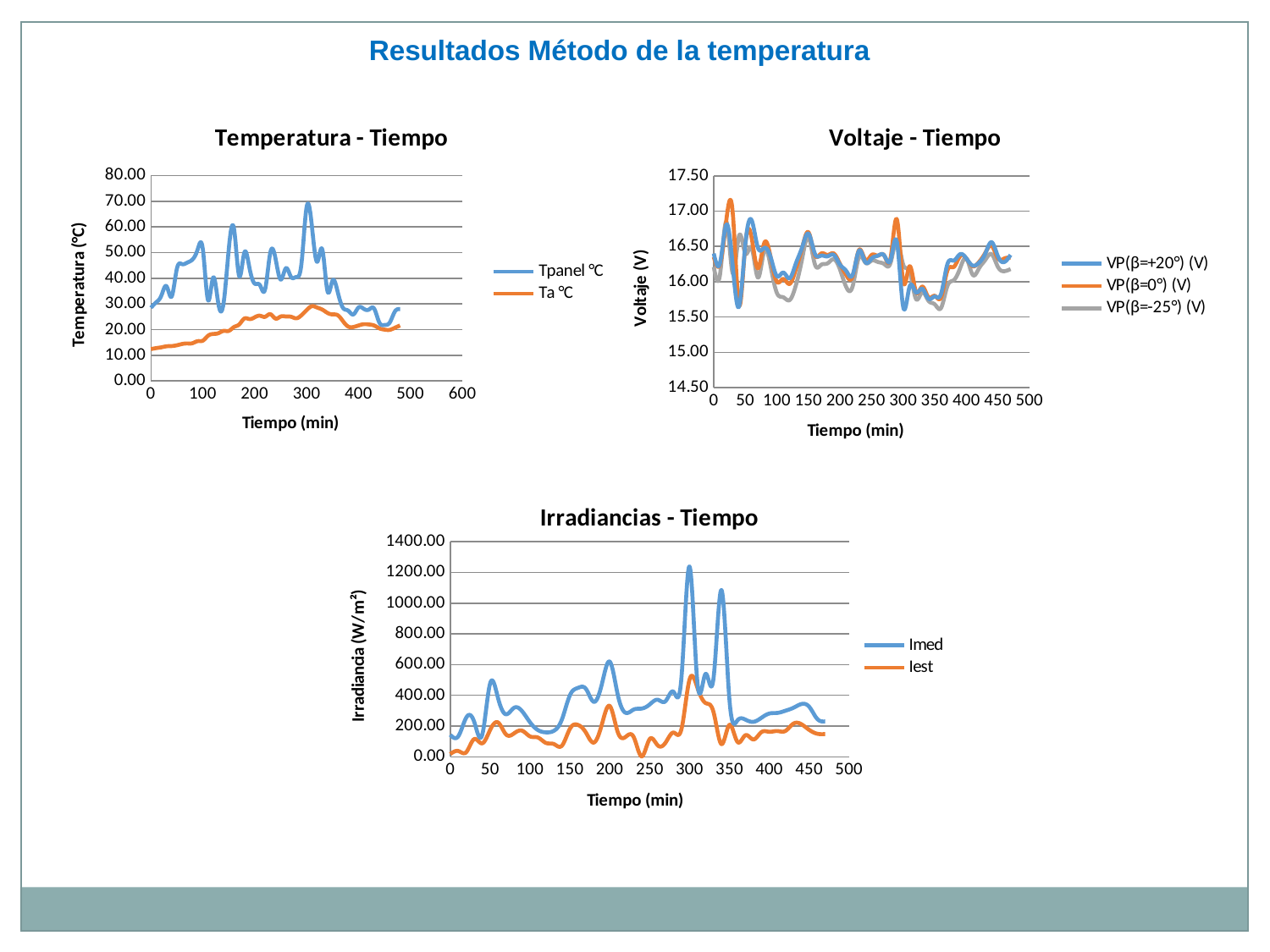
What is the x-axis label on the Temperatura - Tiempo chart? Tiempo (min) On the Temperatura - Tiempo chart, is the highest value of Tpanel °C greater or less than 60.00? greater On the Irradiancias - Tiempo chart, is the highest value of Imed greater or less than 1000.00? greater On the Temperatura - Tiempo chart, is the value of Ta °C at 0 min greater or less than 20.00? less On the Irradiancias - Tiempo chart, which series reaches higher values, Imed or Iest? Imed What kind of chart is the Irradiancias - Tiempo chart? Line chart On the Temperatura - Tiempo chart, how many series does the legend list? 2 On the Voltaje - Tiempo chart, how many series does the legend list? 3 What are the legend entries on the Voltaje - Tiempo chart? VP(β=+20°) (V), VP(β=0°) (V), VP(β=-25°) (V) On the Temperatura - Tiempo chart, which series has higher values overall, Tpanel °C or Ta °C? Tpanel °C